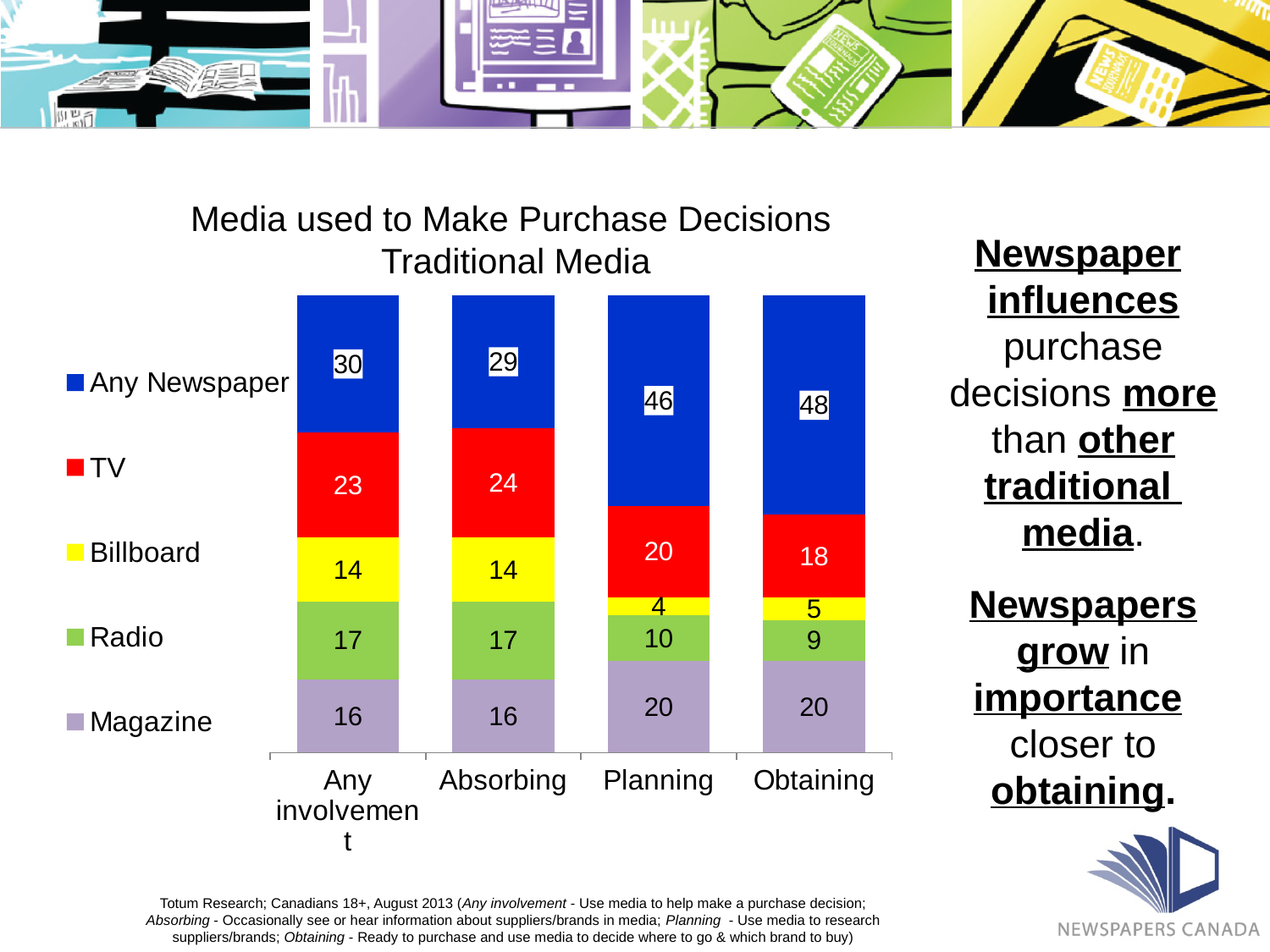
What is the total of the stacked bar for Planning? 100 What is the Any Newspaper value for Obtaining? 48 What kind of chart is shown? Stacked bar chart Is the TV value larger for Any involvement or for Planning? Any involvement Which category has the lowest Radio value? Obtaining Which category has the highest Any Newspaper value? Obtaining What is the TV value for Absorbing? 24 How many series does the legend list? 5 What is the Billboard value for Planning? 4 What is the difference between the Any Newspaper values for Planning and Absorbing? 17 How many categories are shown on the x axis? 4 What is the Magazine value for Any involvement? 16